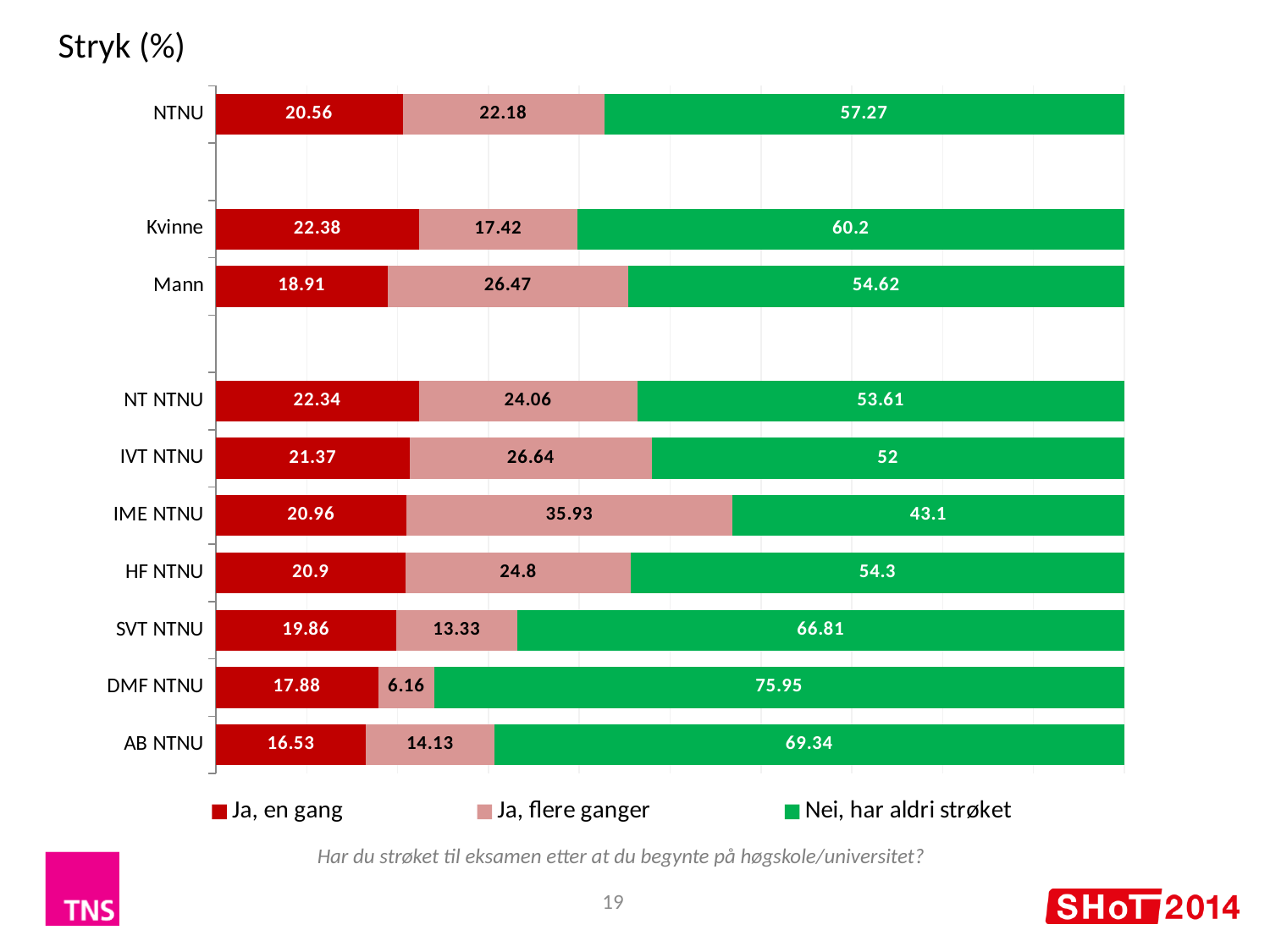
Which has a larger value for "Nei, har aldri strøket", IVT NTNU or HF NTNU? HF NTNU How many series does the legend list? 3 What is the value for "Ja, flere ganger" for Mann? 26.47 What kind of chart is shown on the slide? Stacked bar chart Which category has the highest value for "Ja, flere ganger"? IME NTNU Which category has the highest value for "Nei, har aldri strøket"? DMF NTNU What is the difference between the "Ja, en gang" values for Kvinne and Mann? 3.47 What is the value for "Ja, flere ganger" for NTNU? 22.18 How many categories are shown on the chart? 10 Which category has the lowest value for "Ja, en gang"? AB NTNU Which category has the lowest value for "Ja, flere ganger"? DMF NTNU What is the value for "Nei, har aldri strøket" for DMF NTNU? 75.95